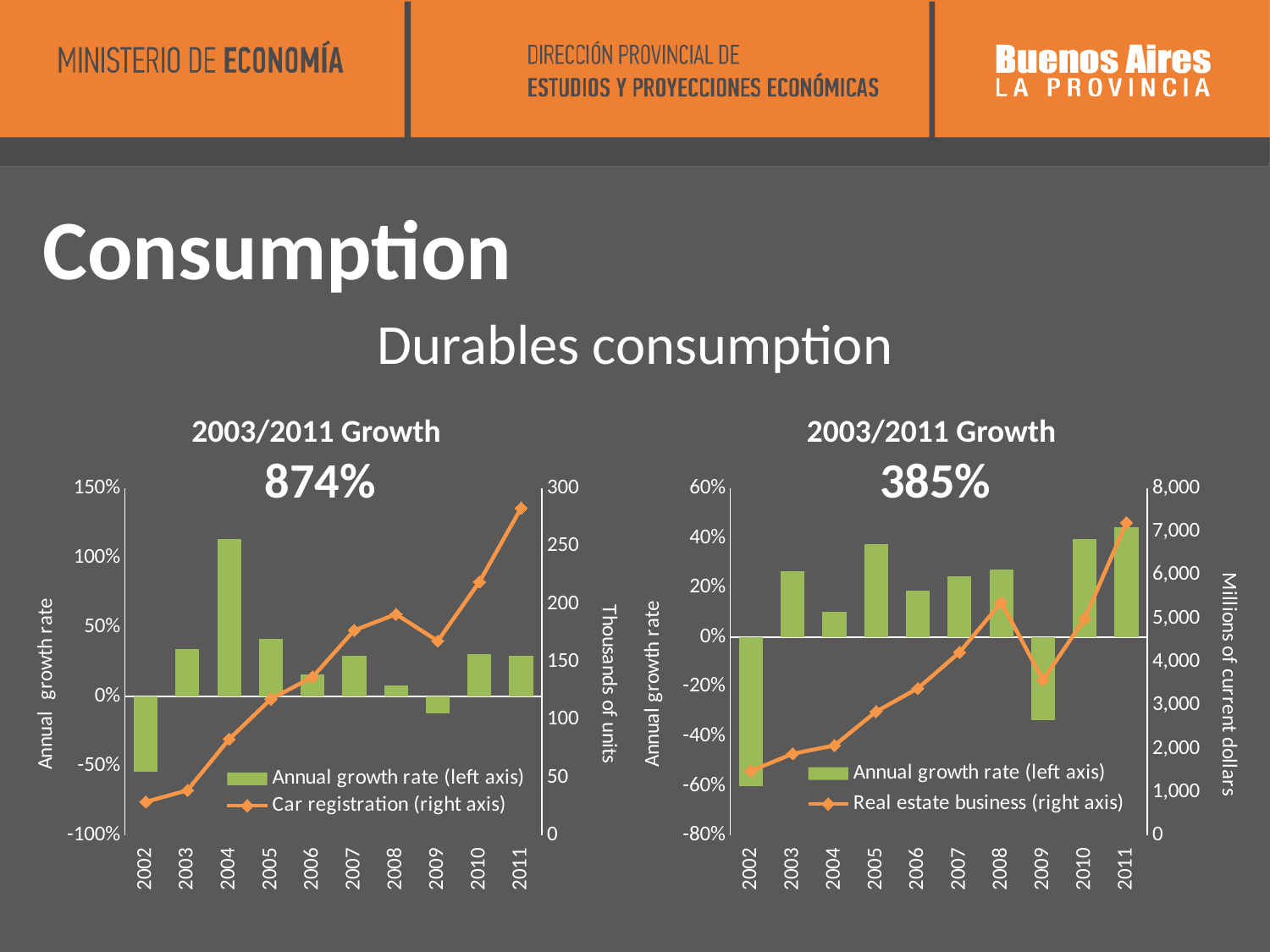
On the left chart (car registration), how many series does the legend list? 2 What 2003/2011 growth figure is shown above the right chart (real estate business)? 385% On the left chart (car registration), which year has the highest annual growth rate bar? 2004 On the right chart, is the real estate business line higher in 2011 or in 2009? 2011 On the right chart, is the annual growth rate for 2009 greater or less than -20%? less On the left chart (car registration), what kind of chart is it? Combined bar and line chart On the right chart (real estate business), which year has the lowest annual growth rate bar? 2002 On the right chart (real estate business), how many years are shown on the x axis? 10 On the left chart, is the car registration value for 2011 greater or less than 250 thousand units? greater On the left chart (car registration), which year has the lowest annual growth rate bar? 2002 On the right chart, is the real estate business value for 2008 greater or less than 5,000 million current dollars? greater